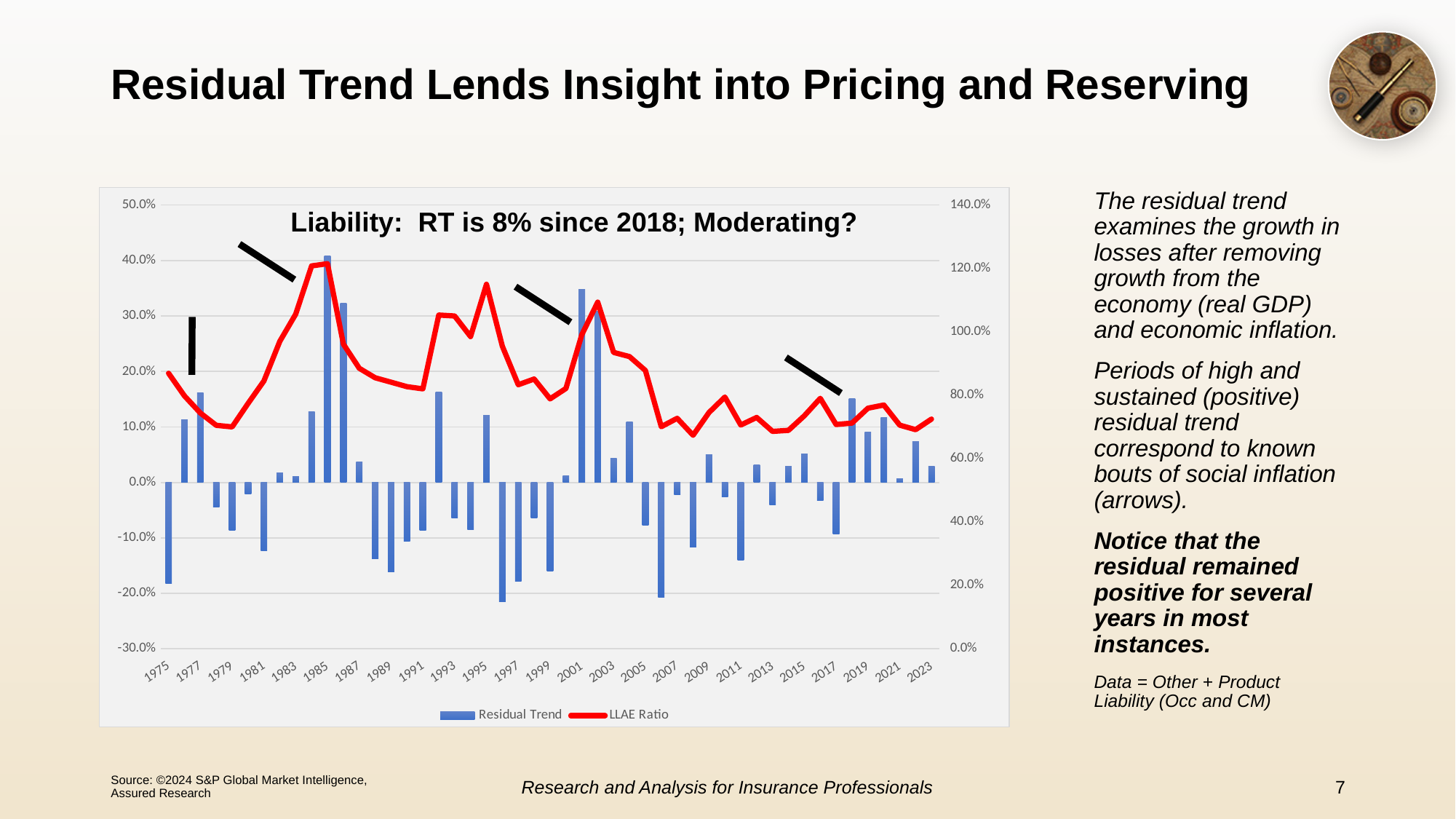
Is the Residual Trend value for 1985 greater or less than 30.0%? greater What is the title printed inside the chart? Liability: RT is 8% since 2018; Moderating? What kind of chart is shown on the slide? A combined bar and line chart In which year does the LLAE Ratio line reach its highest point? 1985 Is the LLAE Ratio for 2023 greater or less than 80.0%? less What are the two series named in the chart legend? Residual Trend and LLAE Ratio Is the LLAE Ratio for 1985 greater or less than 100.0%? greater In which year is the Residual Trend bar the highest? 1985 Does the LLAE Ratio line rise or fall between 1979 and 1985? rise How many series does the chart legend list? 2 Which year has the larger Residual Trend bar, 1985 or 2001? 1985